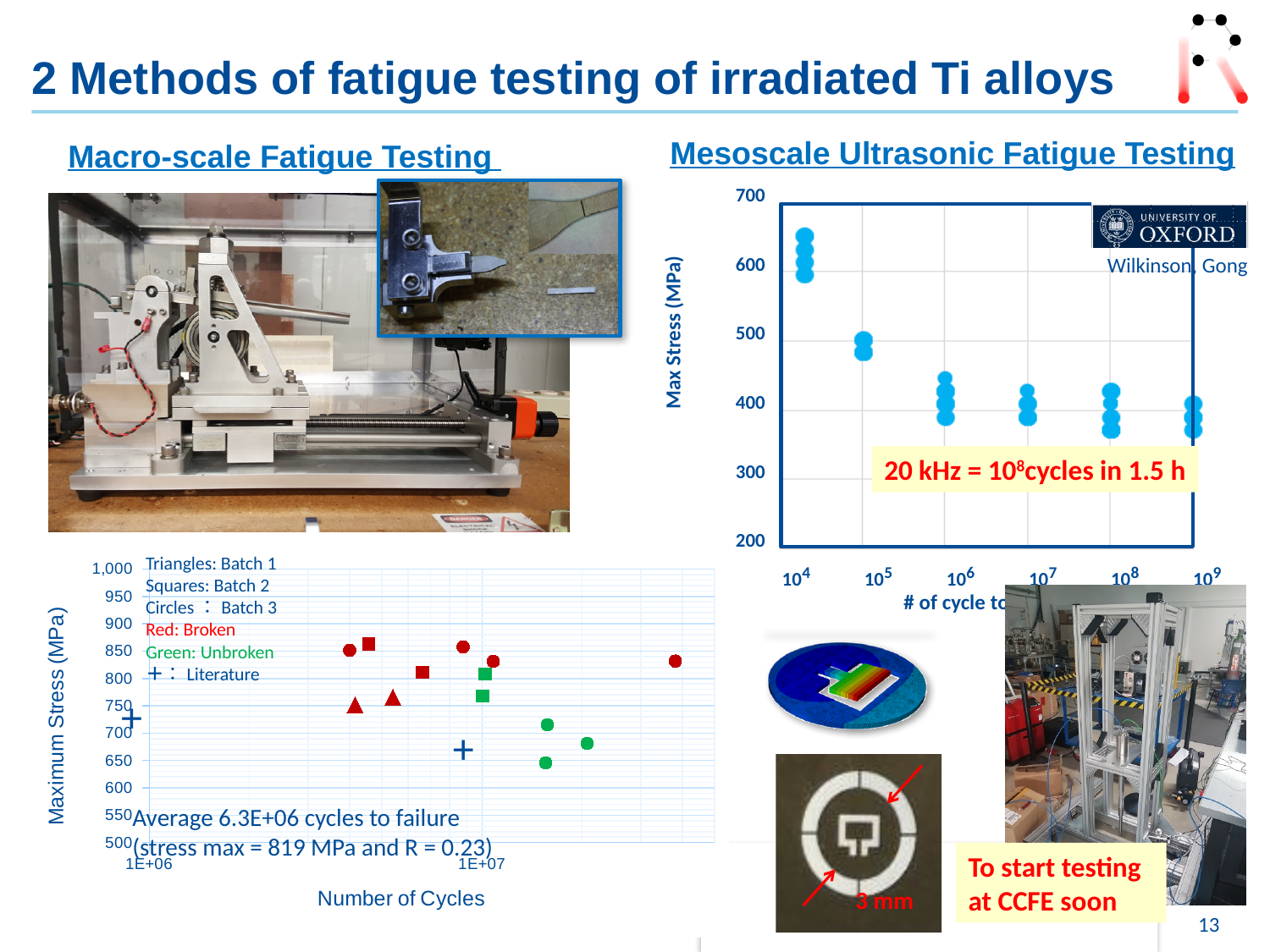
In the right-hand ultrasonic fatigue chart, are the points at 10^9 cycles greater or less than 500 MPa? less In the bottom-left chart, is the '+' literature point near 5E+06 cycles greater or less than 700 MPa? less In the right-hand ultrasonic fatigue chart, are the points at 10^6 cycles greater or less than 300 MPa? greater In the right-hand ultrasonic fatigue chart, what is the y-axis label? Max Stress (MPa) In the bottom-left chart, what does a green marker indicate according to the legend text? Unbroken What type of chart is the 'Mesoscale Ultrasonic Fatigue Testing' chart on the right? scatter chart In the bottom-left chart, how many red squares (Batch 2, broken) are plotted? 2 In the bottom-left chart, how many red triangles (Batch 1, broken) are plotted? 2 In the right-hand ultrasonic fatigue chart, do the max stress values rise or fall as the number of cycles increases? fall In the right-hand ultrasonic fatigue chart, what is the lowest value shown on the y axis? 200 What type of chart is the chart at the bottom left with 'Number of Cycles' on the x axis? scatter chart